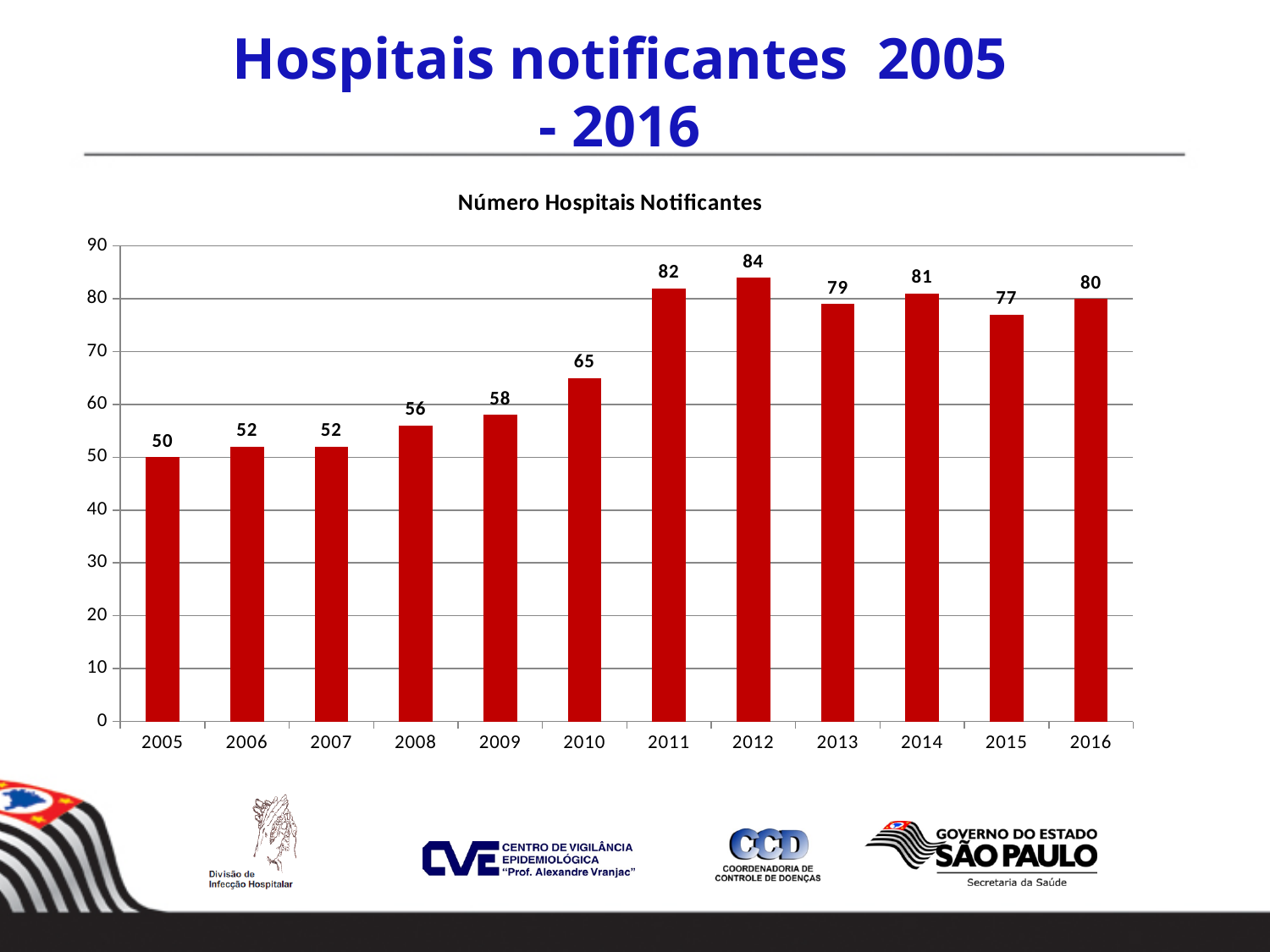
What is the value for 2015? 77 Which year has the highest value? 2012 What is the difference between the values for 2012 and 2005? 34 What kind of chart is shown on the slide? bar chart What is the title of the chart? Número Hospitais Notificantes Is the value for 2009 greater or less than 60? less What is the value for 2010? 65 How many years are shown on the x axis? 12 Which year has the lowest value? 2005 What is the value for 2005? 50 What is the difference between the values for 2011 and 2010? 17 Which is larger, the value for 2013 or the value for 2016? 2016